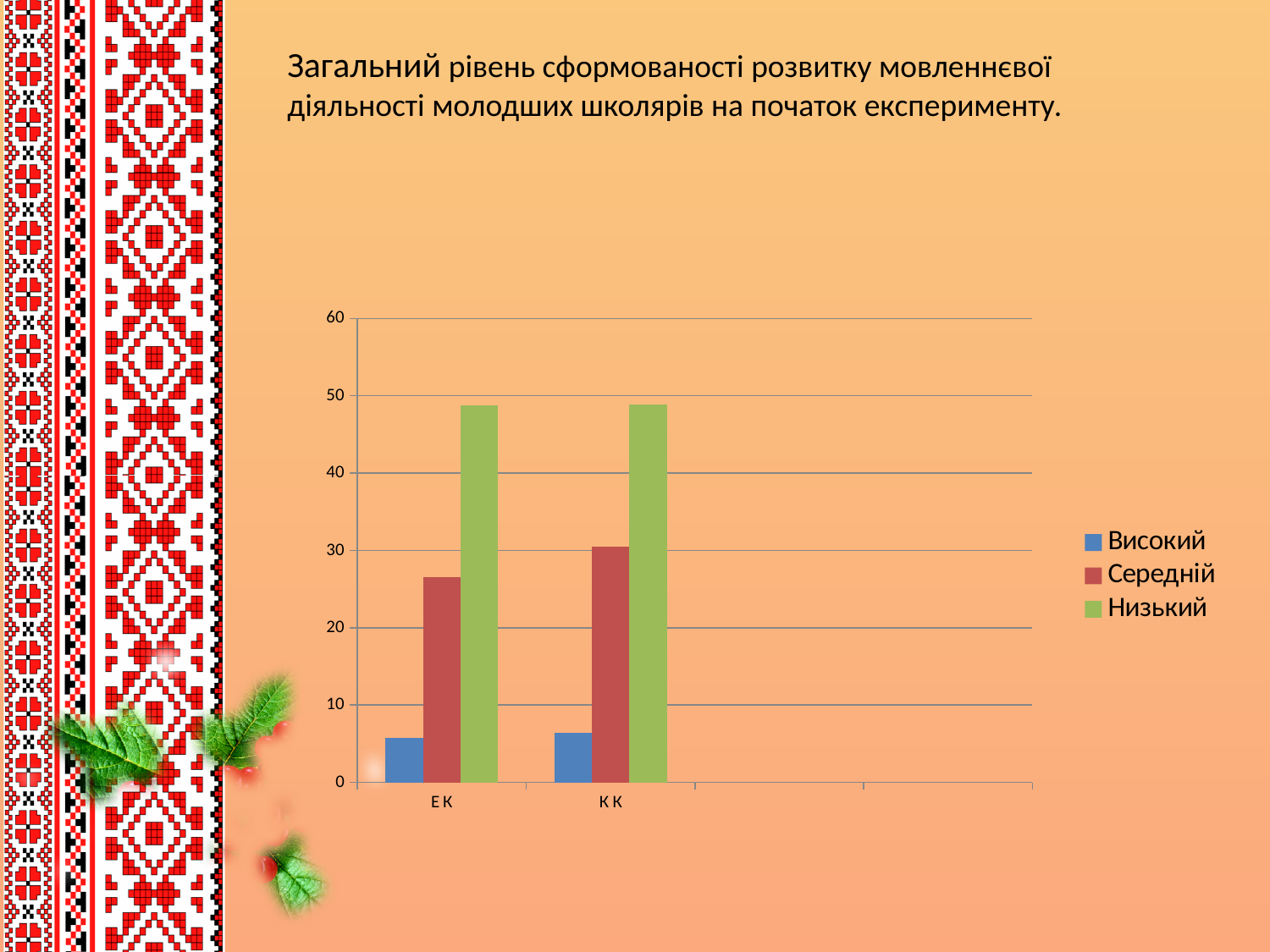
Which is larger, the Середній value for ЕК or for КК? КК How many categories are shown on the x axis? 2 Is the value of Високий for КК greater or less than 10? less How many series does the legend list? 3 Is the value of Середній for ЕК greater or less than 30? less Is the value of Низький for ЕК greater or less than 40? greater What is the highest value shown on the y axis? 60 Which series has the highest value for ЕК? Низький Which series is shown in green in the legend? Низький What kind of chart is shown on the slide? bar chart Which series has the lowest value for КК? Високий